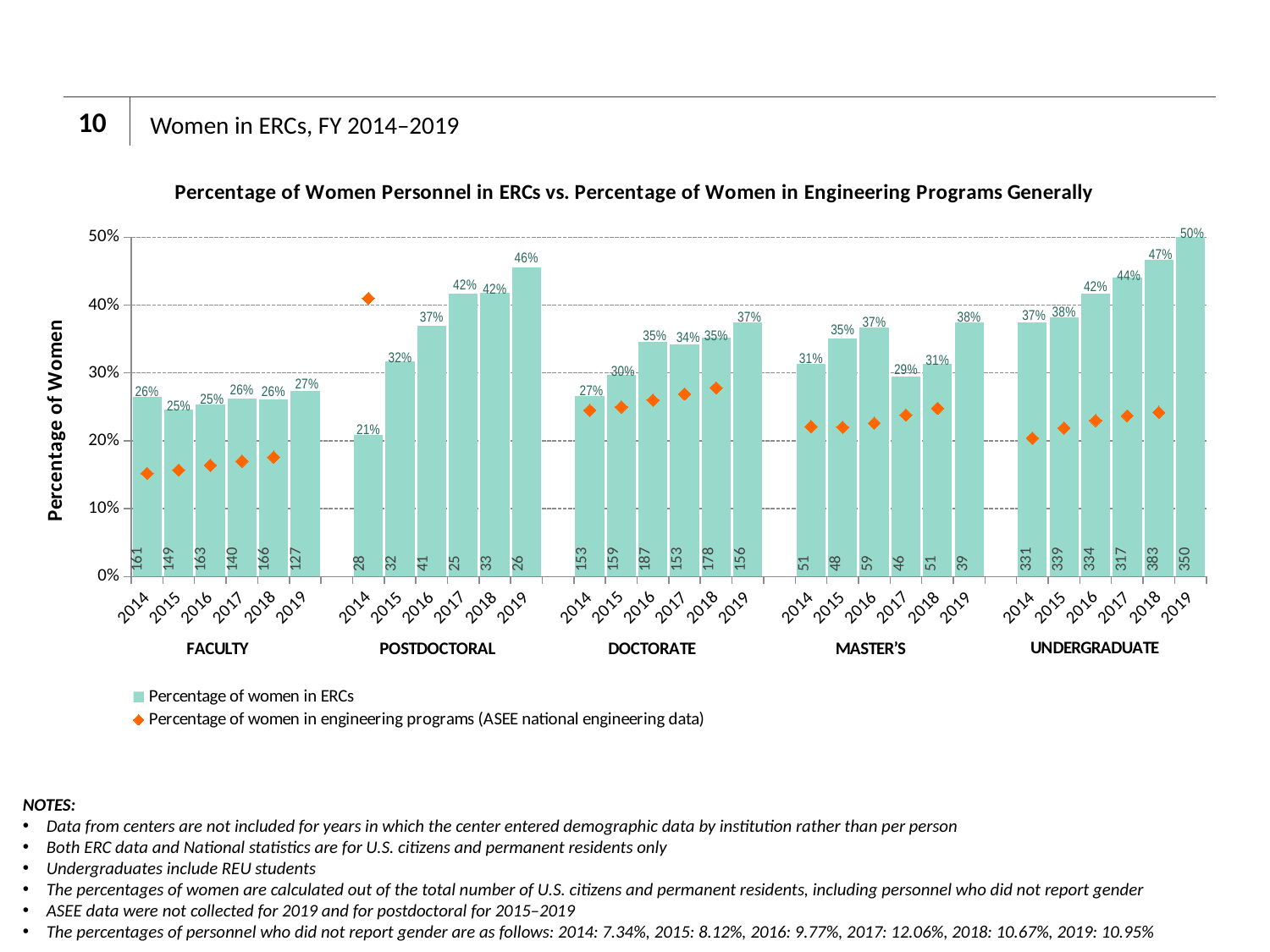
By how many percentage points did the percentage of women in ERCs for Postdoctoral increase from 2014 to 2019? 25 percentage points What is the title of the vertical axis? Percentage of Women Which group and year has the lowest percentage of women in ERCs? Postdoctoral 2014 Which is larger: the percentage of women in ERCs for Master's in 2016 or for Doctorate in 2016? Master's 2016 Do the percentages of women in ERCs for Undergraduate rise or fall from 2014 to 2019? rise How many series does the legend list? 2 Which group and year has the highest percentage of women in ERCs? Undergraduate 2019 What is the percentage of women in ERCs for Undergraduate in 2019? 50% What is the percentage of women in ERCs for Postdoctoral in 2014? 21% Is the percentage of women in engineering programs (diamond marker) for Faculty in 2014 greater or less than 20%? less Is the percentage of women in engineering programs (diamond marker) for Postdoctoral in 2014 greater or less than 40%? greater What number is printed inside the Doctorate 2016 bar? 187